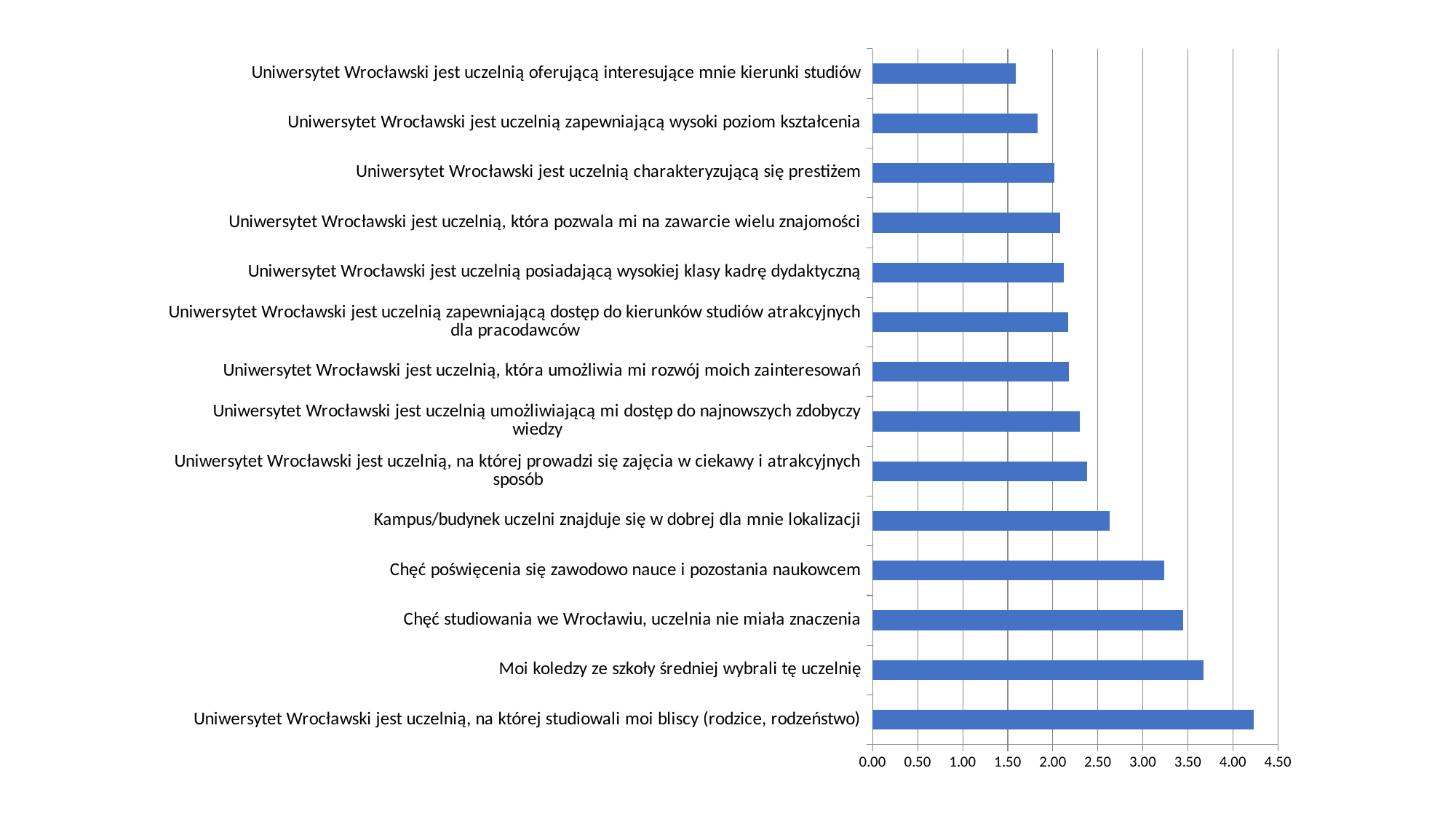
Is the value for "Moi koledzy ze szkoły średniej wybrali tę uczelnię" greater or less than 3.50? greater How many categories (bars) does the chart show? 14 Which has a larger value: "Uniwersytet Wrocławski jest uczelnią zapewniającą wysoki poziom kształcenia" or "Uniwersytet Wrocławski jest uczelnią, na której prowadzi się zajęcia w ciekawy i atrakcyjnych sposób"? Uniwersytet Wrocławski jest uczelnią, na której prowadzi się zajęcia w ciekawy i atrakcyjnych sposób Is the value for "Uniwersytet Wrocławski jest uczelnią, na której studiowali moi bliscy (rodzice, rodzeństwo)" greater or less than 4.00? greater Is the value for "Uniwersytet Wrocławski jest uczelnią oferującą interesujące mnie kierunki studiów" greater or less than 2.00? less Which has a larger value: "Chęć studiowania we Wrocławiu, uczelnia nie miała znaczenia" or "Kampus/budynek uczelni znajduje się w dobrej dla mnie lokalizacji"? Chęć studiowania we Wrocławiu, uczelnia nie miała znaczenia Which category has the lowest value? Uniwersytet Wrocławski jest uczelnią oferującą interesujące mnie kierunki studiów Which category has the highest value? Uniwersytet Wrocławski jest uczelnią, na której studiowali moi bliscy (rodzice, rodzeństwo) What is the maximum value shown on the horizontal axis? 4.50 What kind of chart is shown on the slide? bar chart